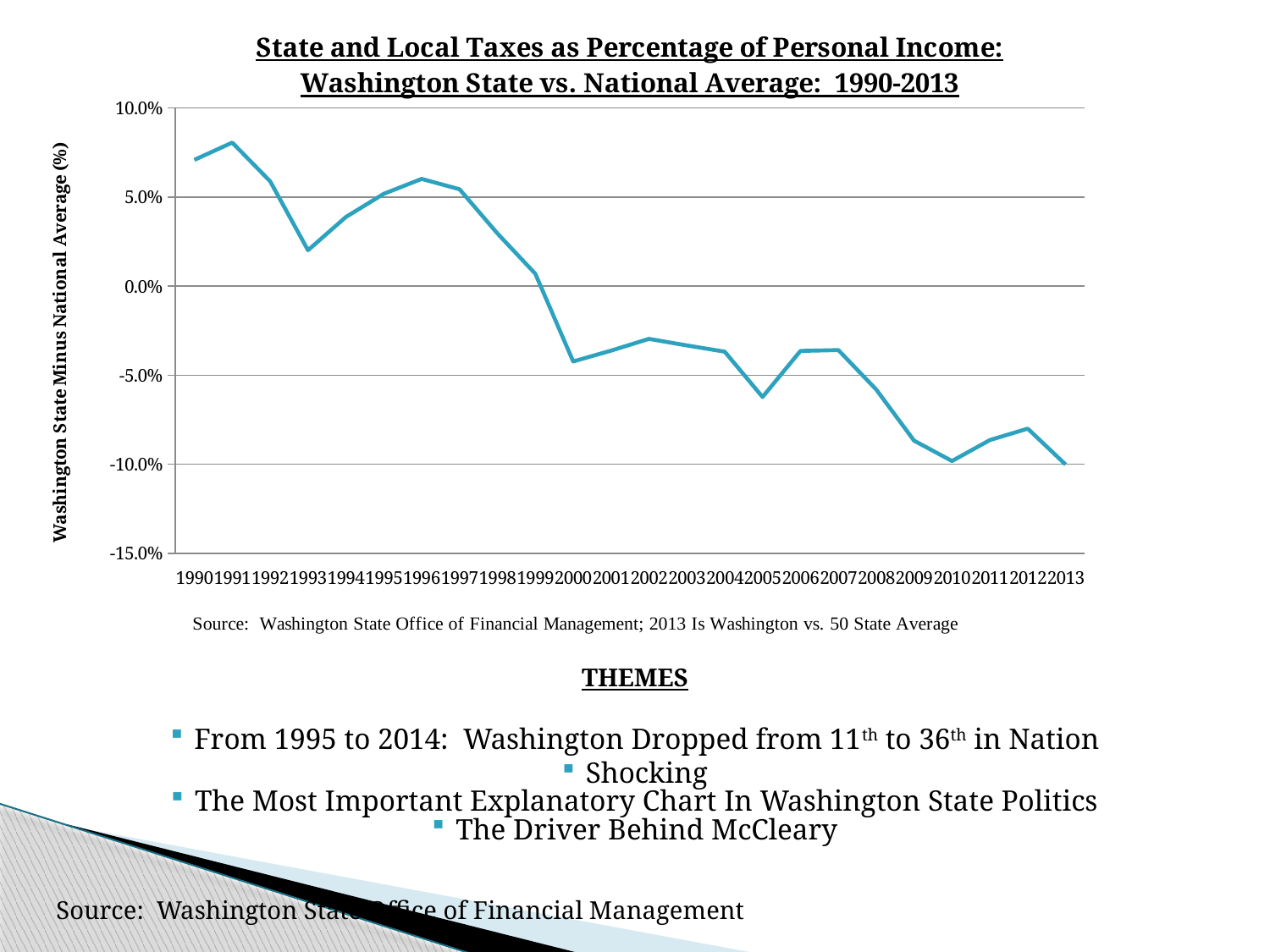
Is the value for 1991 greater or less than 5.0%? greater What is the label on the vertical axis of the chart? Washington State Minus National Average (%) What kind of chart is shown on the slide? Line chart How many years are plotted along the x axis of the chart? 24 Which year has the larger value, 2005 or 2006? 2006 Which year has the larger value, 1990 or 2013? 1990 Is the value for 1993 greater or less than 5.0%? less Overall, do the values rise or fall from 1990 to 2013? Fall Is the value for 2000 greater or less than 0.0%? less In which year does the line reach its highest value? 1991